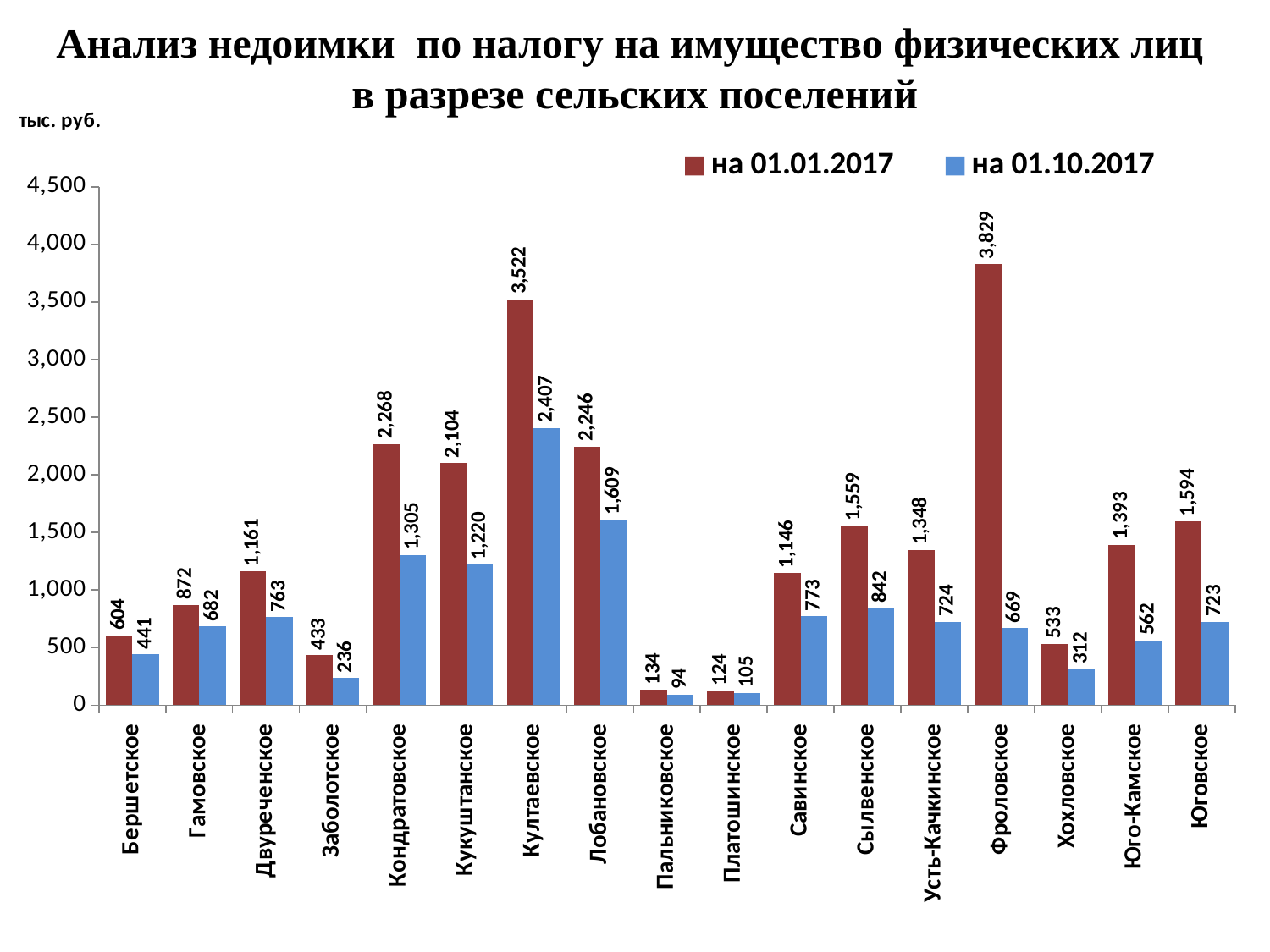
What is the value for Култаевское in the series на 01.10.2017? 2,407 Which settlement has the lowest value in the series на 01.10.2017? Пальниковское Which settlement has the highest value in the series на 01.10.2017? Култаевское How many series does the legend list? 2 What is the difference between the на 01.01.2017 and на 01.10.2017 values for Фроловское? 3,160 What is the difference between the на 01.01.2017 and на 01.10.2017 values for Култаевское? 1,115 What kind of chart is shown on the slide? Bar chart In the series на 01.01.2017, which is larger: Савинское or Усть-Качкинское? Усть-Качкинское What is the value for Заболотское in the series на 01.10.2017? 236 Which settlement has the highest value in the series на 01.01.2017? Фроловское What is the value for Фроловское in the series на 01.01.2017? 3,829 How many settlements are shown on the x axis? 17